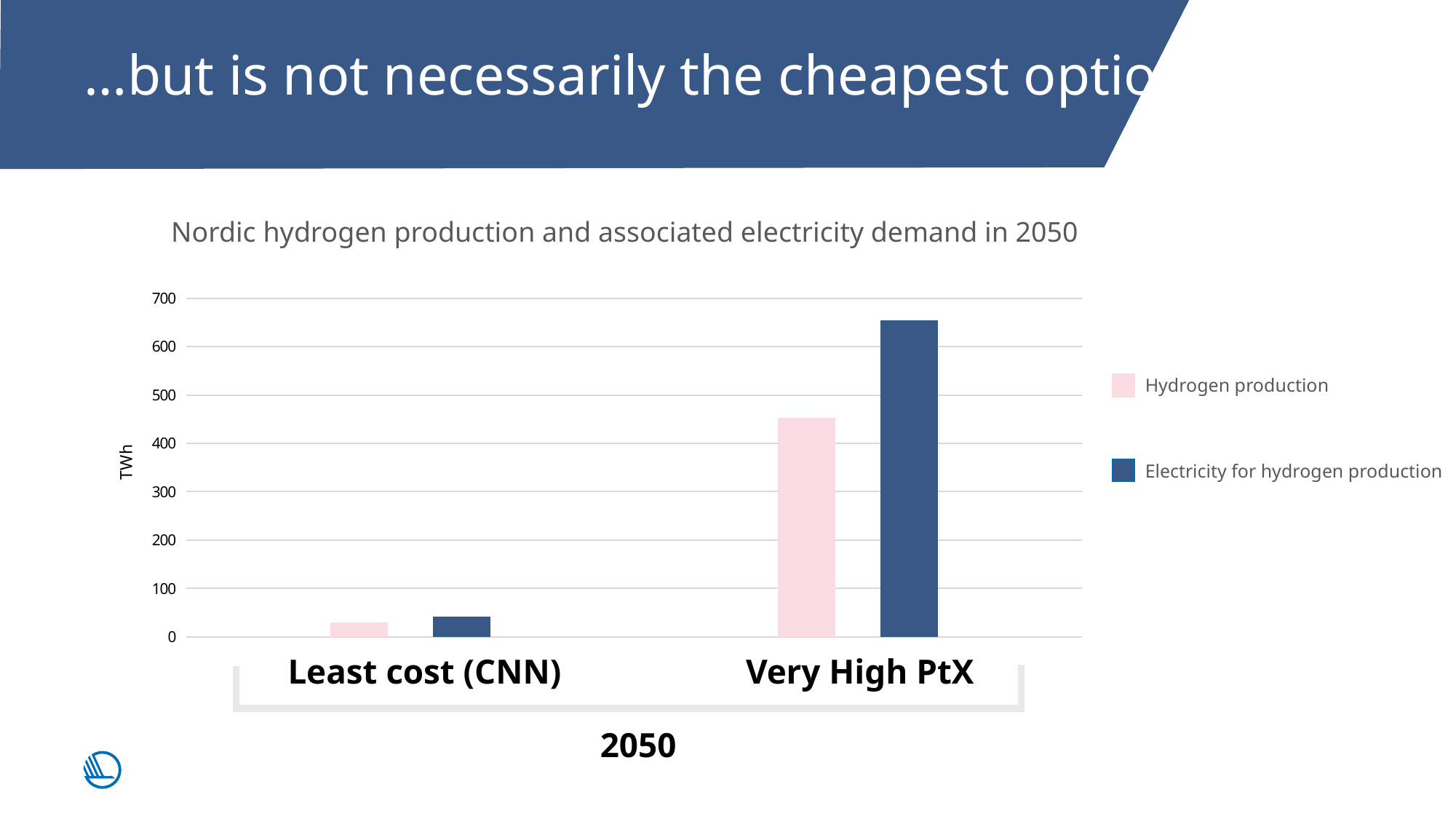
Do the values rise or fall from Least cost (CNN) to Very High PtX? rise What kind of chart is shown on the slide? bar chart Is the value for Electricity for hydrogen production in the Very High PtX scenario greater or less than 600? greater What is the title of the chart? Nordic hydrogen production and associated electricity demand in 2050 In the Very High PtX scenario, which is larger: Hydrogen production or Electricity for hydrogen production? Electricity for hydrogen production Which scenario has the lowest Hydrogen production? Least cost (CNN) What unit is shown on the y axis? TWh How many scenario categories are shown on the x axis? 2 How many series does the legend list? 2 Which scenario has the highest Electricity for hydrogen production? Very High PtX Is the value for Hydrogen production in the Least cost (CNN) scenario greater or less than 100? less Is the value for Hydrogen production in the Very High PtX scenario greater or less than 400? greater